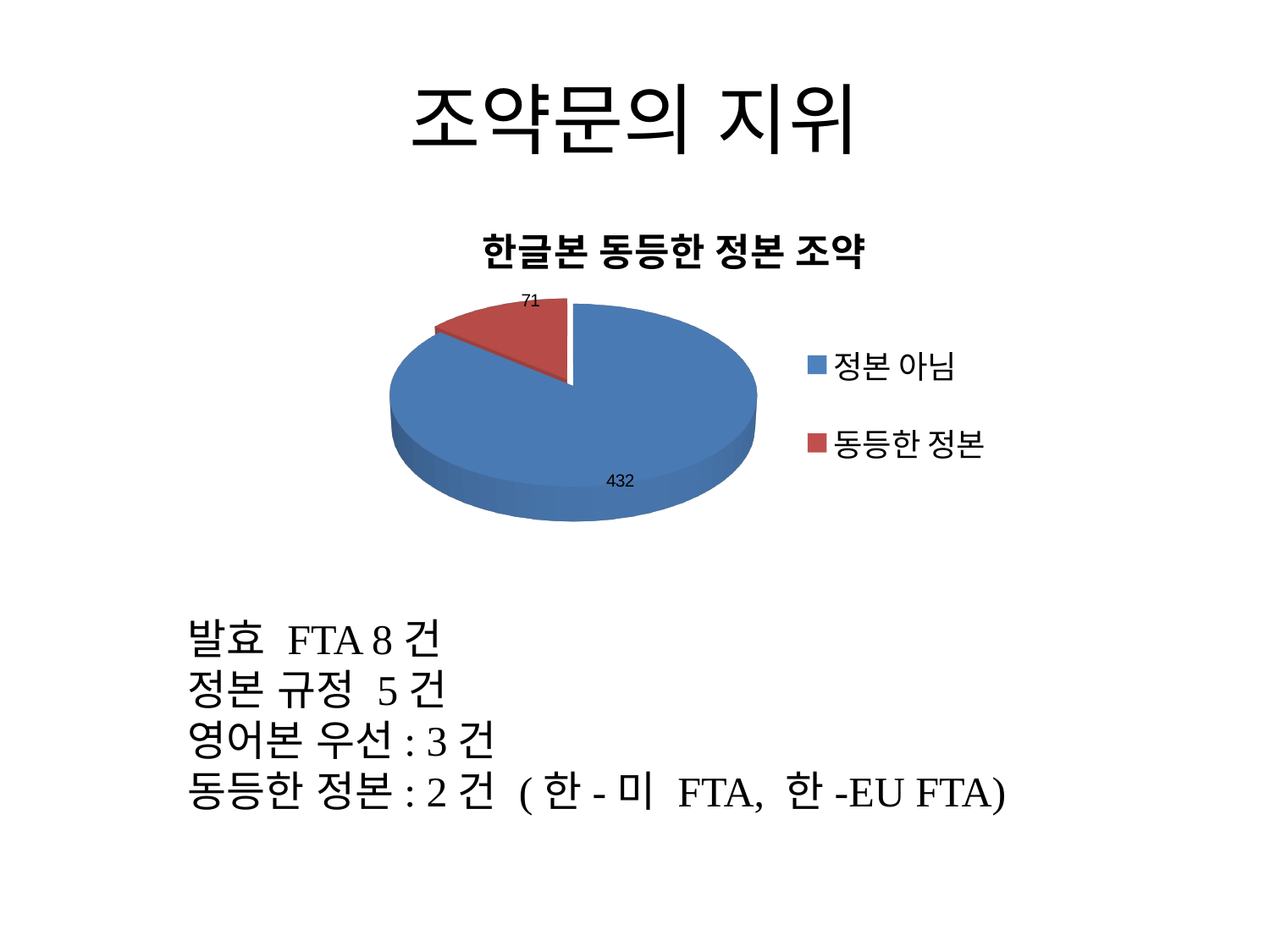
What is the value for 동등한 정본? 71 How many entries does the legend list? 2 What kind of chart is shown on the slide? pie chart How many categories does the pie chart have? 2 What is the value for 정본 아님? 432 Which is larger, the value for 정본 아님 or the value for 동등한 정본? 정본 아님 Which category has the smallest slice of the pie? 동등한 정본 What is the total of all slices in the pie chart? 503 Which category has the largest slice of the pie? 정본 아님 What is the difference between the values for 정본 아님 and 동등한 정본? 361 What colour is the slice for 동등한 정본? red What is the title of the chart? 한글본 동등한 정본 조약